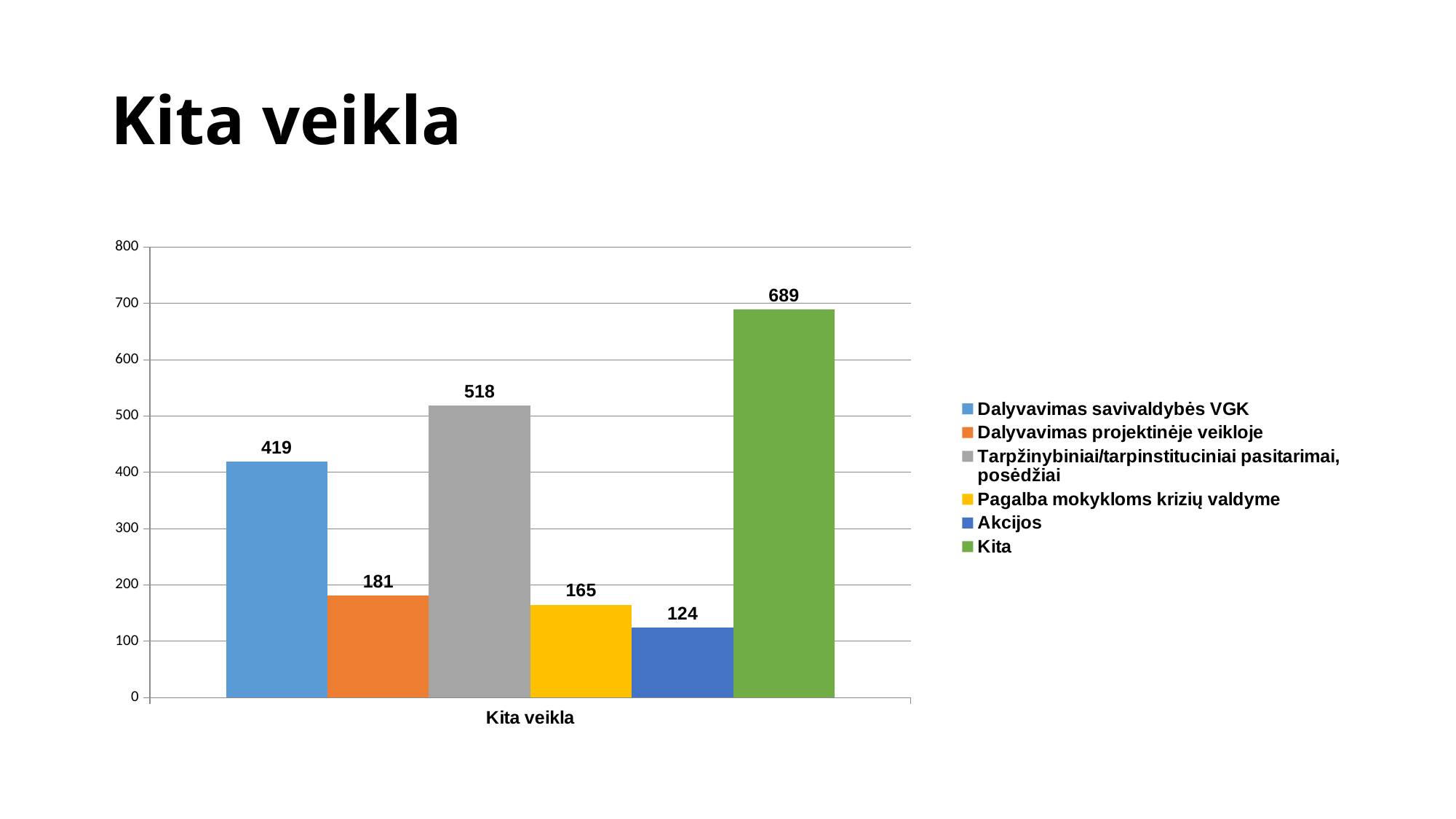
Which series has the lowest value? Akcijos How many series does the legend list? 6 Which series has the highest value? Kita What kind of chart is shown on the slide? bar chart Is the value for Dalyvavimas savivaldybės VGK greater or less than 400? greater What is the difference between the values for Kita and Tarpžinybiniai/tarpinstituciniai pasitarimai, posėdžiai? 171 What is the value for Akcijos? 124 What is the value for Pagalba mokykloms krizių valdyme? 165 What colour is the bar for Kita? green What is the value for Dalyvavimas savivaldybės VGK? 419 Which is larger, the value for Dalyvavimas projektinėje veikloje or the value for Pagalba mokykloms krizių valdyme? Dalyvavimas projektinėje veikloje What is the value for Tarpžinybiniai/tarpinstituciniai pasitarimai, posėdžiai? 518